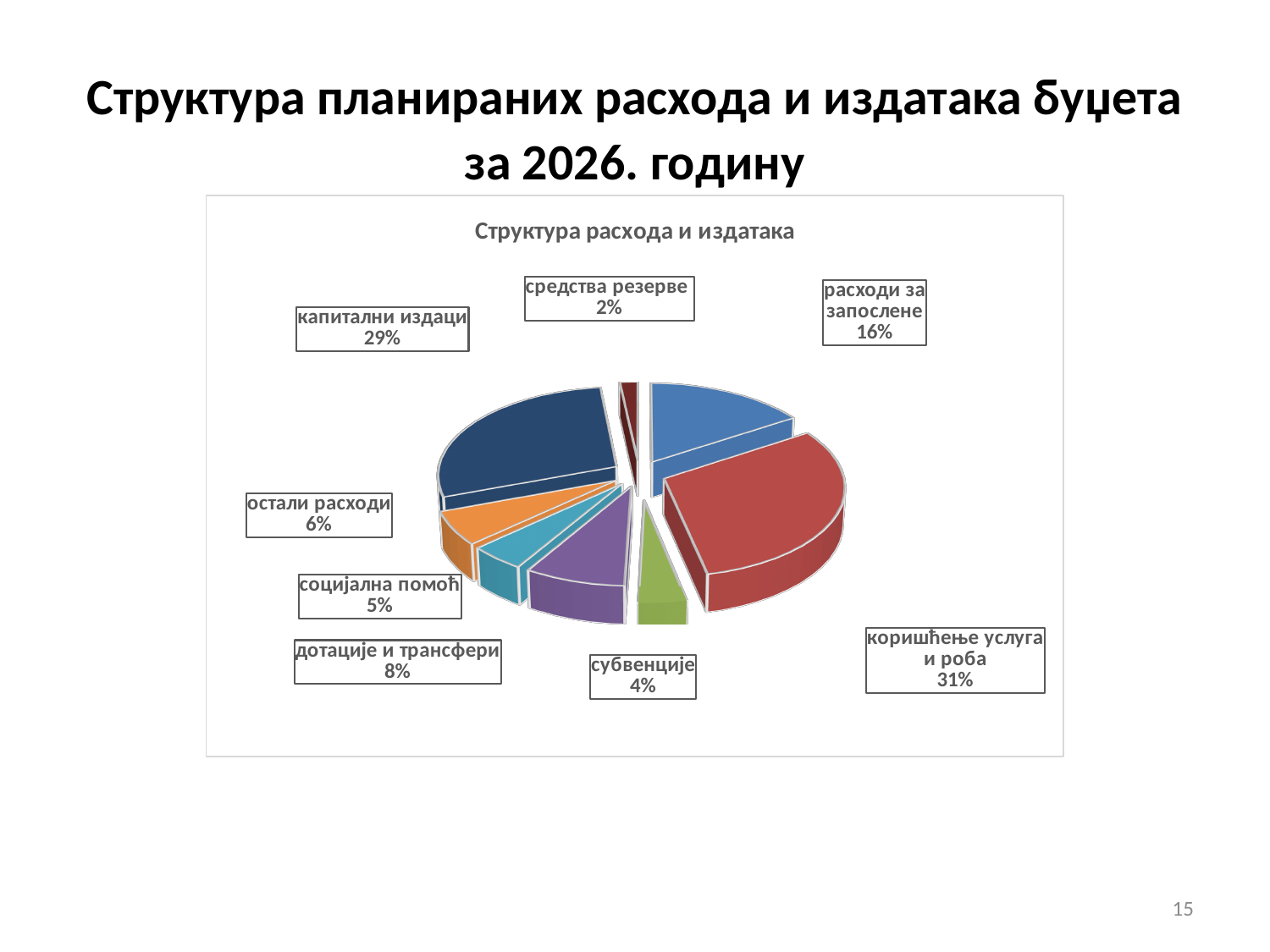
What kind of chart is shown on the slide? pie chart How many categories are shown in the pie chart? 8 Which category has the smallest share of the pie? средства резерве What is the value for средства резерве? 2% What is the value shown for капитални издаци? 29% What share of the pie does коришћење услуга и роба represent? 31% What is the combined share of субвенције and остали расходи? 10% What percentage is shown for расходи за запослене? 16% Which category has the largest share of the pie? коришћење услуга и роба What is the difference in percentage points between коришћење услуга и роба and капитални издаци? 2 What is the title of the chart? Структура расхода и издатака Which is larger, дотације и трансфери or социјална помоћ? дотације и трансфери